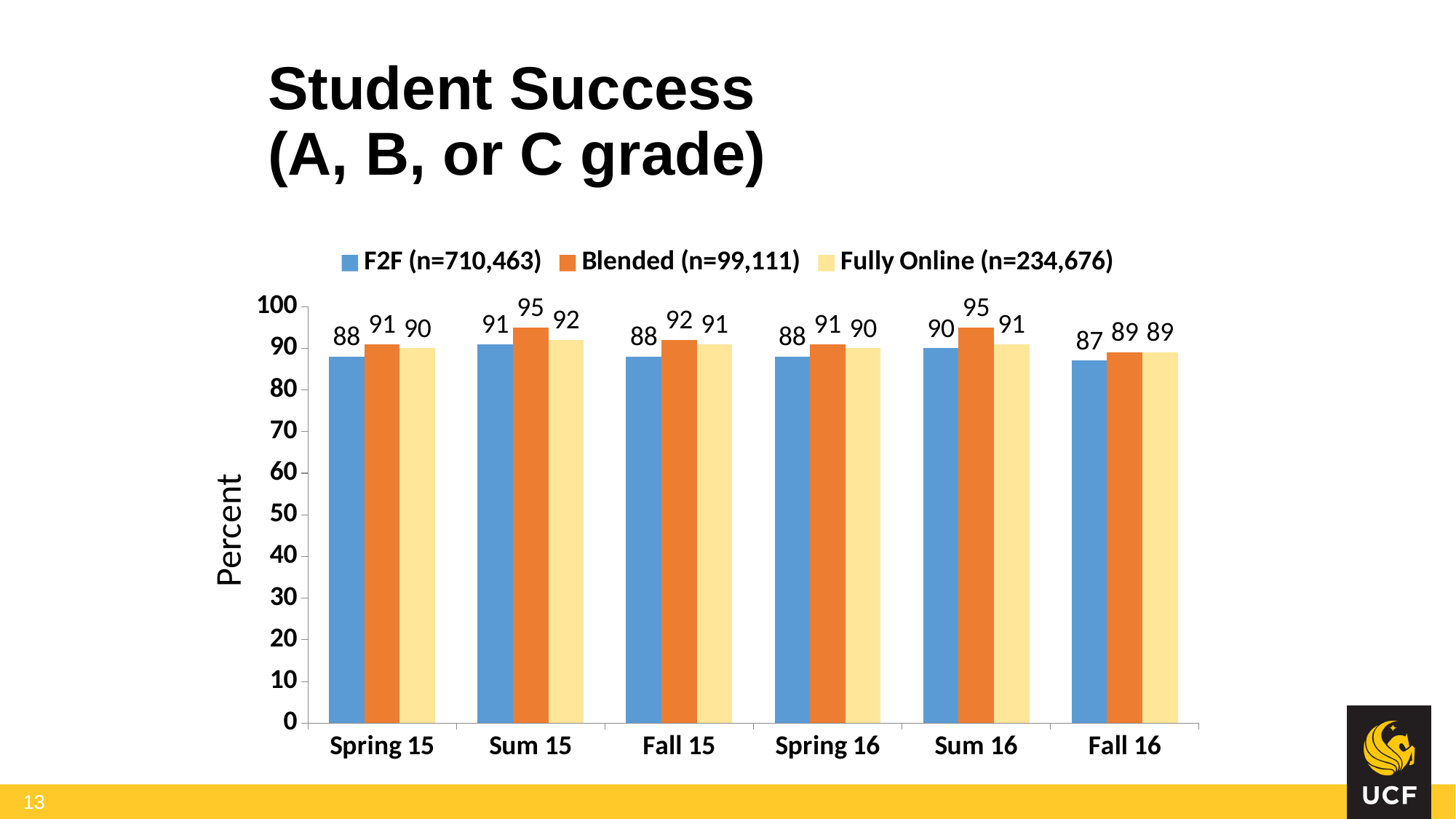
What is the sample size (n) given in the legend for the Blended series? 99,111 How many terms are shown on the x axis? 6 What is the Blended value for Sum 16? 95 What is the F2F value for Spring 15? 88 How many series does the legend list? 3 Which term has the lowest F2F value? Fall 16 What kind of chart is shown on the slide? Bar chart What is the Fully Online value for Fall 16? 89 What is the difference between the Blended and F2F values for Sum 15? 4 Which is larger for Fall 15: the Blended value or the Fully Online value? Blended What is the label on the vertical axis? Percent Which term has the highest Fully Online value? Sum 15